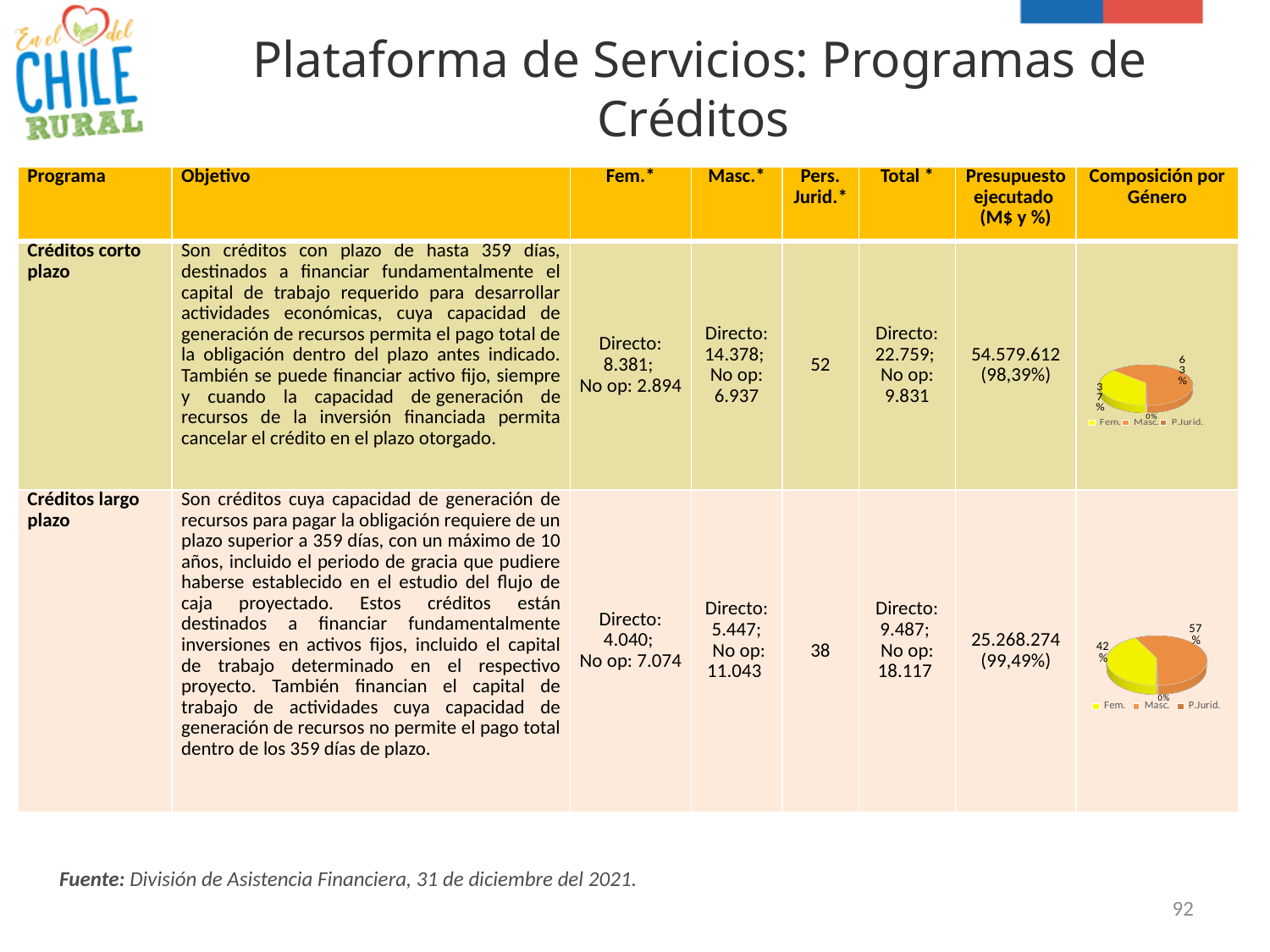
In the Créditos corto plazo pie chart, what share does P.Jurid. have? 0% In the Créditos largo plazo pie chart, what is the difference between the Masc. and Fem. shares? 15% In the Créditos largo plazo pie chart, which category has the largest slice? Masc. In the Créditos largo plazo pie chart, what share does Masc. have? 57% In the Créditos corto plazo pie chart, what share does Masc. have? 63% In the Créditos corto plazo pie chart, which category has the smallest slice? P.Jurid. How many entries does the legend of the Créditos largo plazo pie chart list? 3 What kind of chart is shown in the 'Composición por Género' column for Créditos corto plazo? Pie chart In the Créditos corto plazo pie chart, is the Fem. slice larger or smaller than the Masc. slice? Smaller In the Créditos largo plazo pie chart, which colour represents Fem.? Yellow